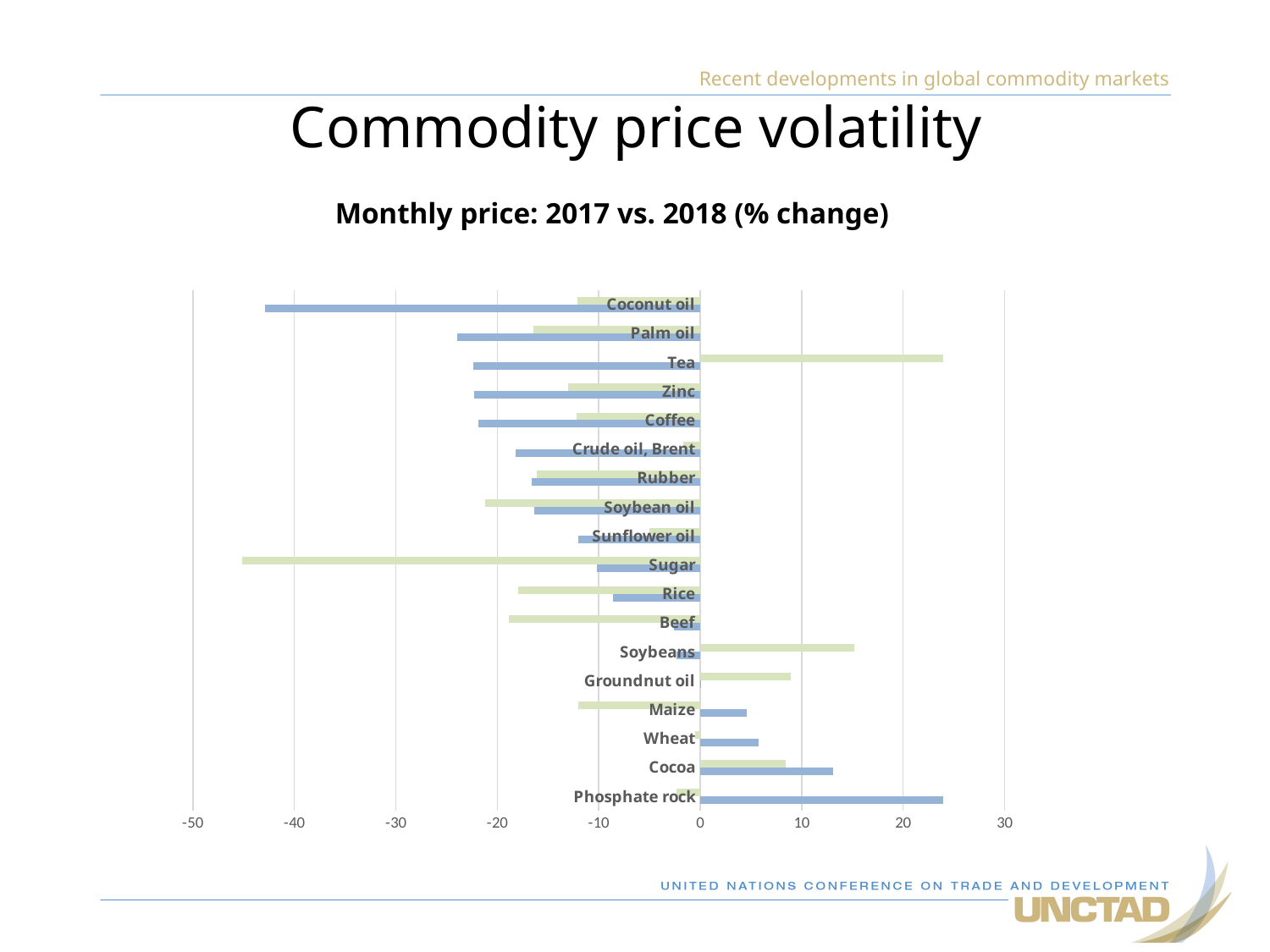
What is the title of the chart? Monthly price: 2017 vs. 2018 (% change) Is the value of the green bar for Sugar greater or less than -40? less Which commodity has the highest green bar value? Tea What kind of chart is shown on the slide? Bar chart Which commodity has the lowest (most negative) green bar value? Sugar Is the value of the blue bar for Palm oil greater or less than -20? less How many commodities are listed on the chart? 18 Is the value of the green bar for Soybeans greater or less than 10? greater Which commodity has the lowest (most negative) blue bar value? Coconut oil